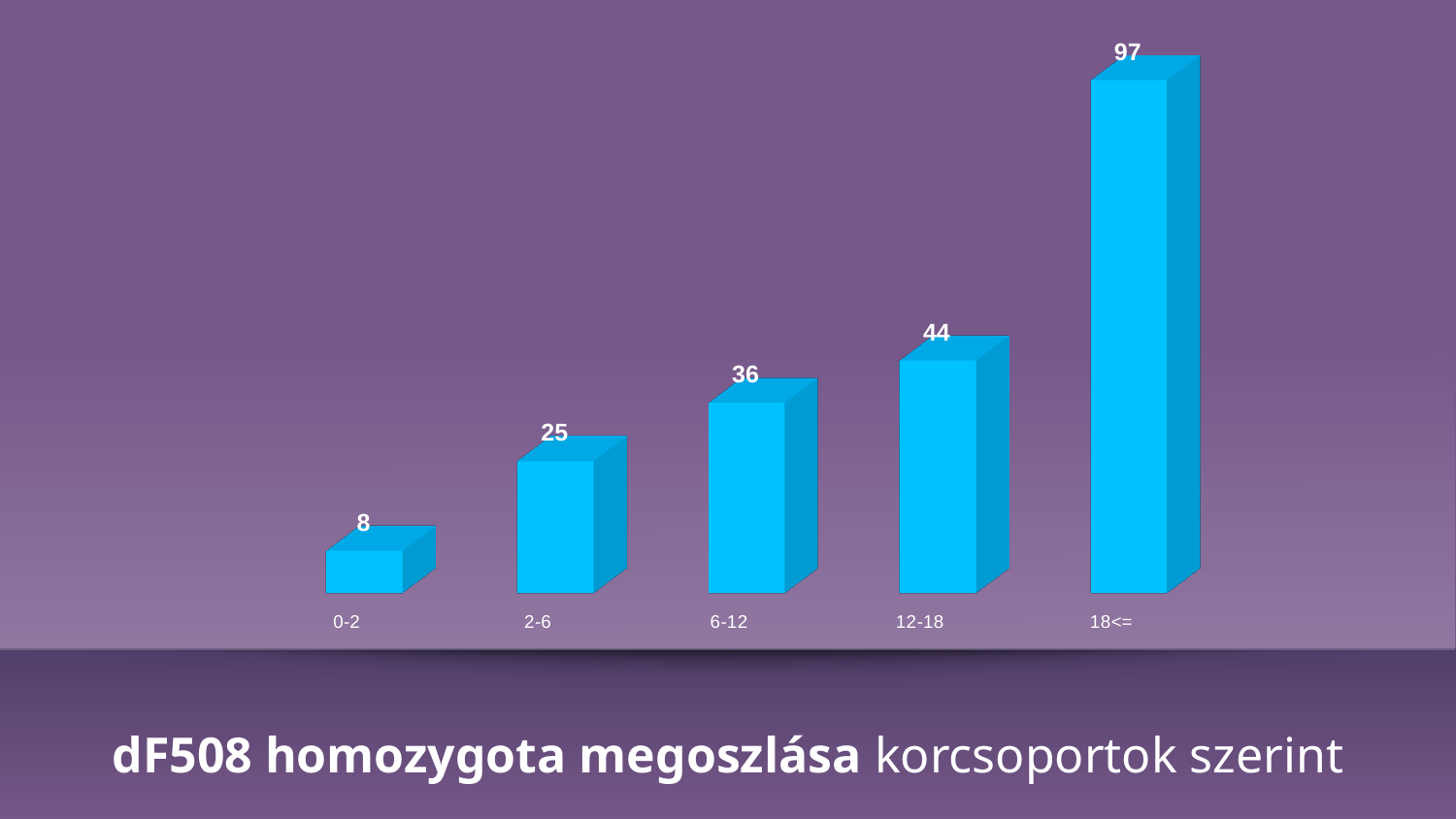
What is the value for the 18<= age group? 97 What is the value for the 6-12 age group? 36 What is the difference between the values for 18<= and 12-18? 53 Which age group has the highest value? 18<= How many age groups are shown in the chart? 5 What is the title text shown at the bottom of the slide? dF508 homozygota megoszlása korcsoportok szerint What is the value for the 0-2 age group? 8 Do the values rise or fall from the 0-2 group to the 18<= group? rise What is the difference between the values for 12-18 and 2-6? 19 Which is larger, the value for 2-6 or the value for 6-12? 6-12 What kind of chart is shown on the slide? bar chart Which age group has the lowest value? 0-2